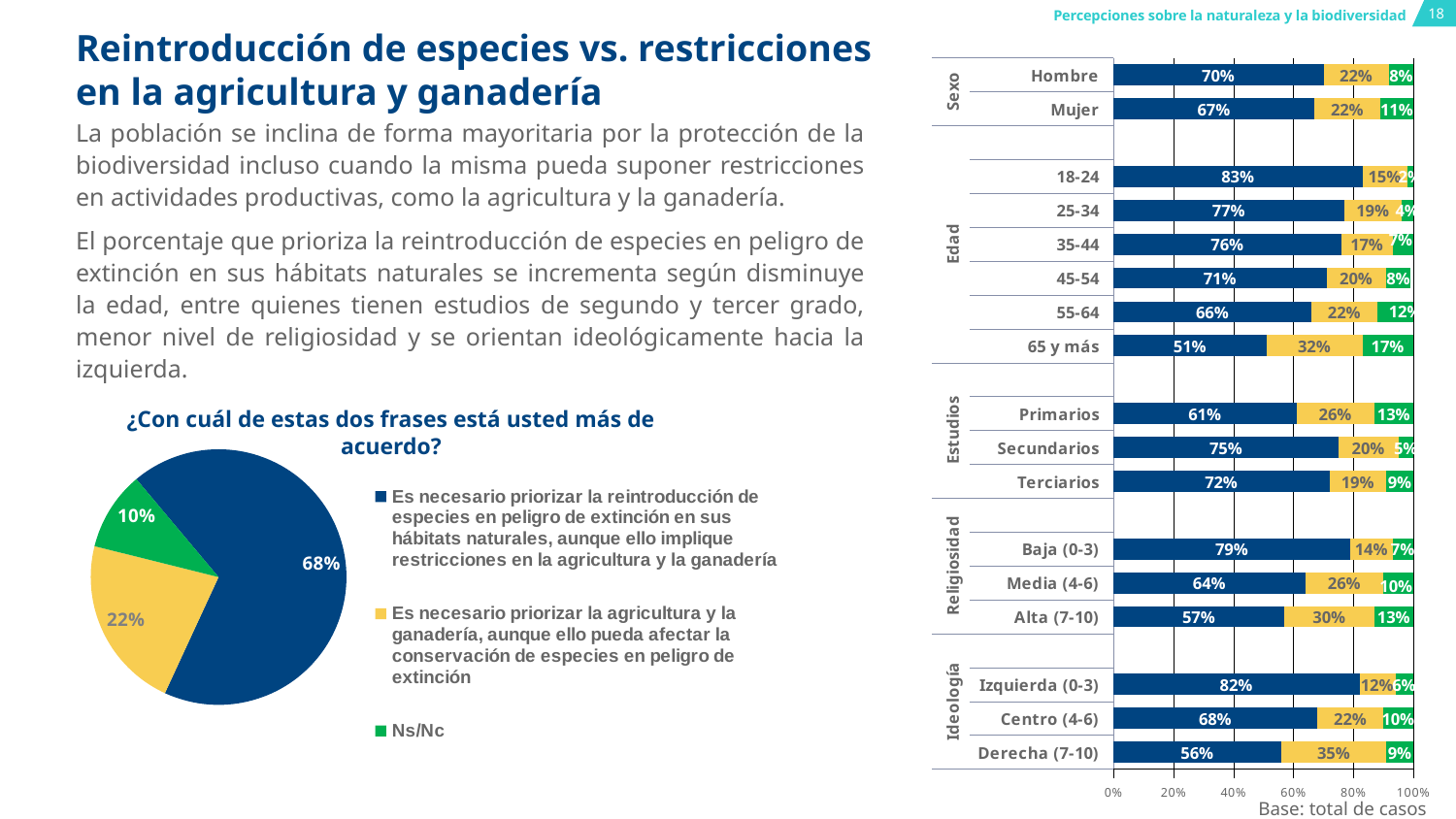
What kind of chart is the one on the left of the slide? Pie chart In the bar chart on the right, which ideology category has the lowest blue segment value? Derecha (7-10) In the pie chart on the left, what percentage corresponds to 'Ns/Nc'? 10% In the bar chart on the right, what is the value of the first (blue) segment for '65 y más'? 51% How many entries does the legend of the pie chart on the left list? 3 In the bar chart on the right, what is the value of the yellow segment for 'Derecha (7-10)'? 35% In the bar chart on the right, which has a larger blue segment value: 'Baja (0-3)' or 'Alta (7-10)'? Baja (0-3) In the bar chart on the right, which age group has the highest blue segment value? 18-24 In the pie chart on the left, what share of respondents chose 'Es necesario priorizar la reintroducción de especies en peligro de extinción...'? 68% In the bar chart on the right, how many categories are shown under 'Edad'? 6 In the bar chart on the right, what is the difference between the blue segment values for 'Hombre' and 'Mujer'? 3 percentage points What kind of chart is the one on the right of the slide? Stacked bar chart